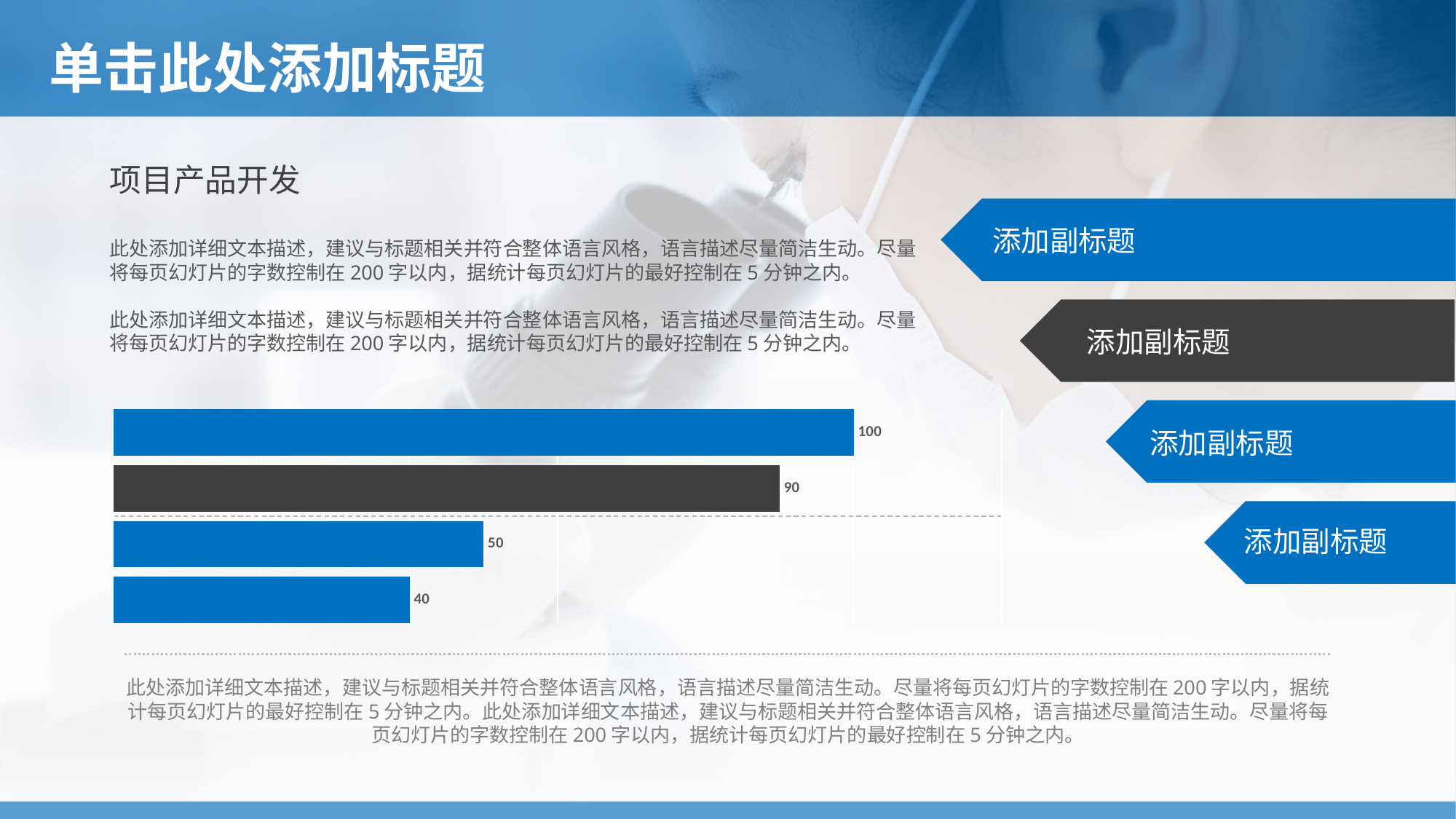
Do the bar values increase or decrease from the top bar to the bottom bar? decrease What is the value of the top bar in the chart? 100 What colour is the second bar from the top? dark gray What type of chart is shown on the slide? bar chart What is the highest value shown in the chart? 100 Which is larger, the second bar from the top or the third bar from the top? the second bar from the top What is the value of the third bar from the top? 50 What is the value of the bottom bar in the chart? 40 What is the difference between the top bar and the bottom bar? 60 How many bars does the chart contain? 4 What is the lowest value shown in the chart? 40 What is the value of the second bar from the top? 90